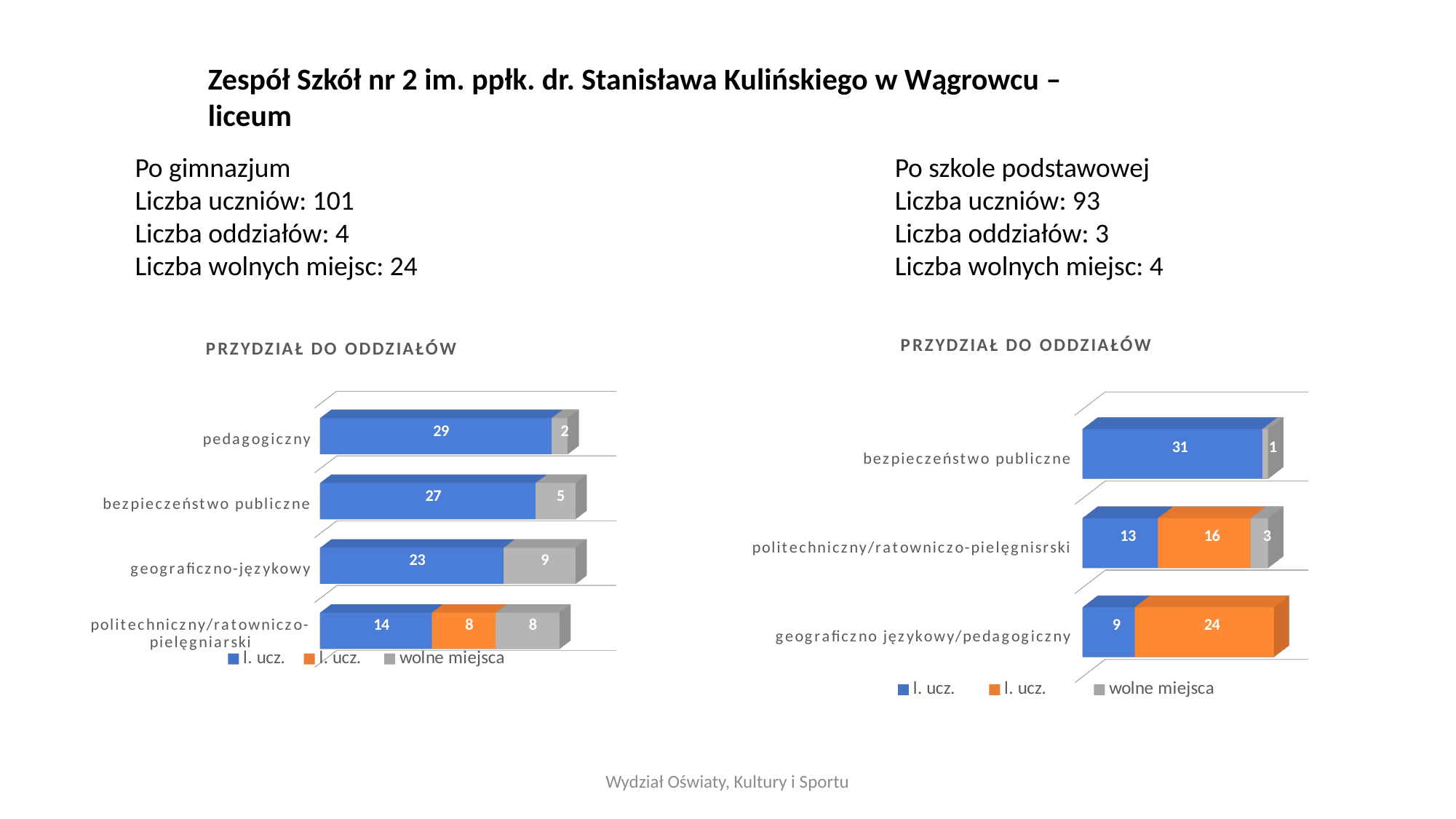
In the left chart, which category has the most free places (wolne miejsca)? geograficzno-językowy In the left chart, what is the difference between the blue values for pedagogiczny and geograficzno-językowy? 6 In the right chart, what is the orange (second l. ucz.) value for geograficzno językowy/pedagogiczny? 24 In the left chart, what is the total of the stacked bar for politechniczny/ratowniczo-pielęgniarski? 30 In the right chart, is the blue value for bezpieczeństwo publiczne larger or smaller than the blue value for politechniczny/ratowniczo-pielęgnisrski? larger In the left chart, how many categories are shown? 4 In the left chart, how many free places (wolne miejsca) are shown for bezpieczeństwo publiczne? 5 What type of chart is the right chart? bar chart In the left chart, what is the blue (first l. ucz.) value for pedagogiczny? 29 In the right chart, how many series does the legend list? 3 In the right chart, what is the total of the stacked bar for politechniczny/ratowniczo-pielęgnisrski? 32